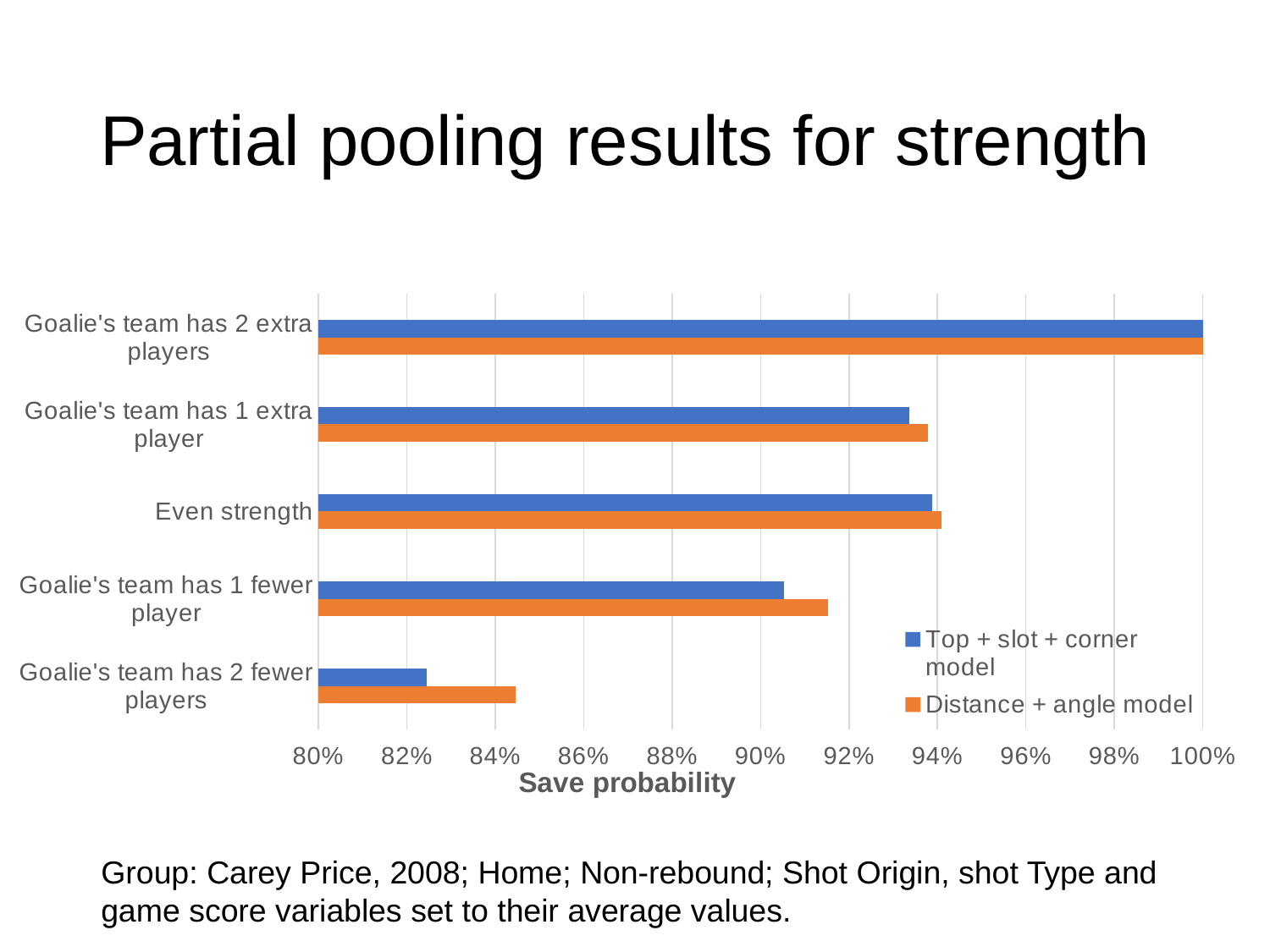
What is the label of the x axis? Save probability How many series does the legend list? 2 What kind of chart is shown on the slide? bar chart Which colour represents the Distance + angle model? orange Which category has the highest save probability for the Top + slot + corner model? Goalie's team has 2 extra players Is the Top + slot + corner model value for 'Goalie's team has 2 fewer players' greater or less than 84%? less For 'Goalie's team has 1 fewer player', which model has the larger save probability? Distance + angle model Is the Distance + angle model value for 'Goalie's team has 1 fewer player' greater or less than 90%? greater Which category has the lowest save probability for the Distance + angle model? Goalie's team has 2 fewer players How many strength categories are plotted on the chart? 5 Is the Distance + angle model value for 'Goalie's team has 2 fewer players' greater or less than 86%? less